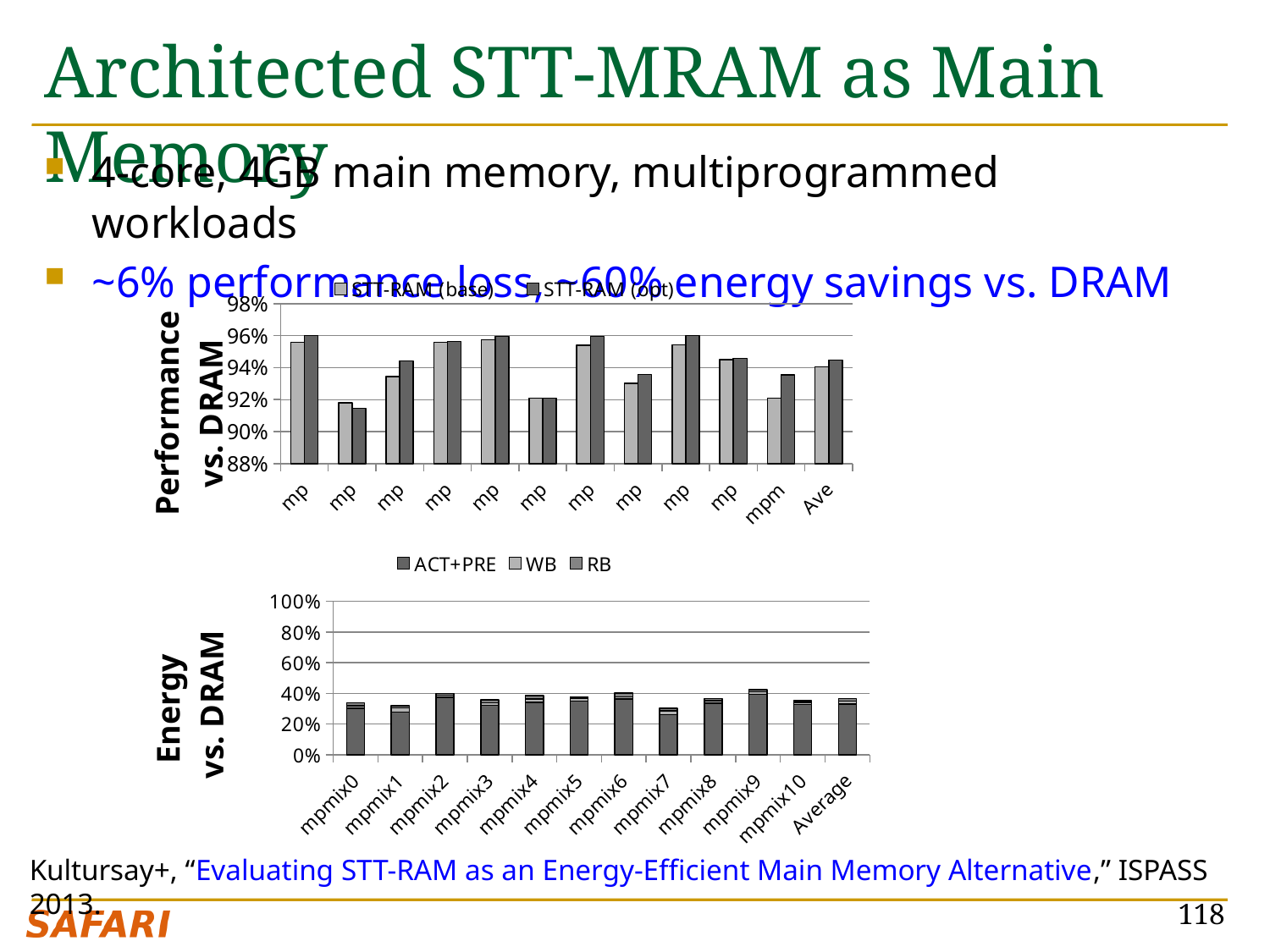
What kind of chart is the top chart (Performance vs. DRAM)? bar chart What kind of chart is the bottom chart (Energy vs. DRAM)? bar chart In the bottom chart (Energy vs. DRAM), how many categories are shown on the x axis? 12 In the bottom chart (Energy vs. DRAM), what are the three legend entries? ACT+PRE, WB, RB In the bottom chart (Energy vs. DRAM), how many series does the legend list? 3 In the bottom chart (Energy vs. DRAM), is the total for mpmix7 greater or less than 40%? less In the top chart (Performance vs. DRAM), how many series does the legend list? 2 In the top chart (Performance vs. DRAM), is the STT-RAM (opt) value for Ave greater or less than 96%? less In the bottom chart (Energy vs. DRAM), is the total for Average greater or less than 60%? less In the bottom chart (Energy vs. DRAM), which category has the tallest stacked bar? mpmix9 In the bottom chart (Energy vs. DRAM), which has the taller stacked bar, mpmix2 or mpmix7? mpmix2 In the bottom chart (Energy vs. DRAM), which category has the shortest stacked bar? mpmix7